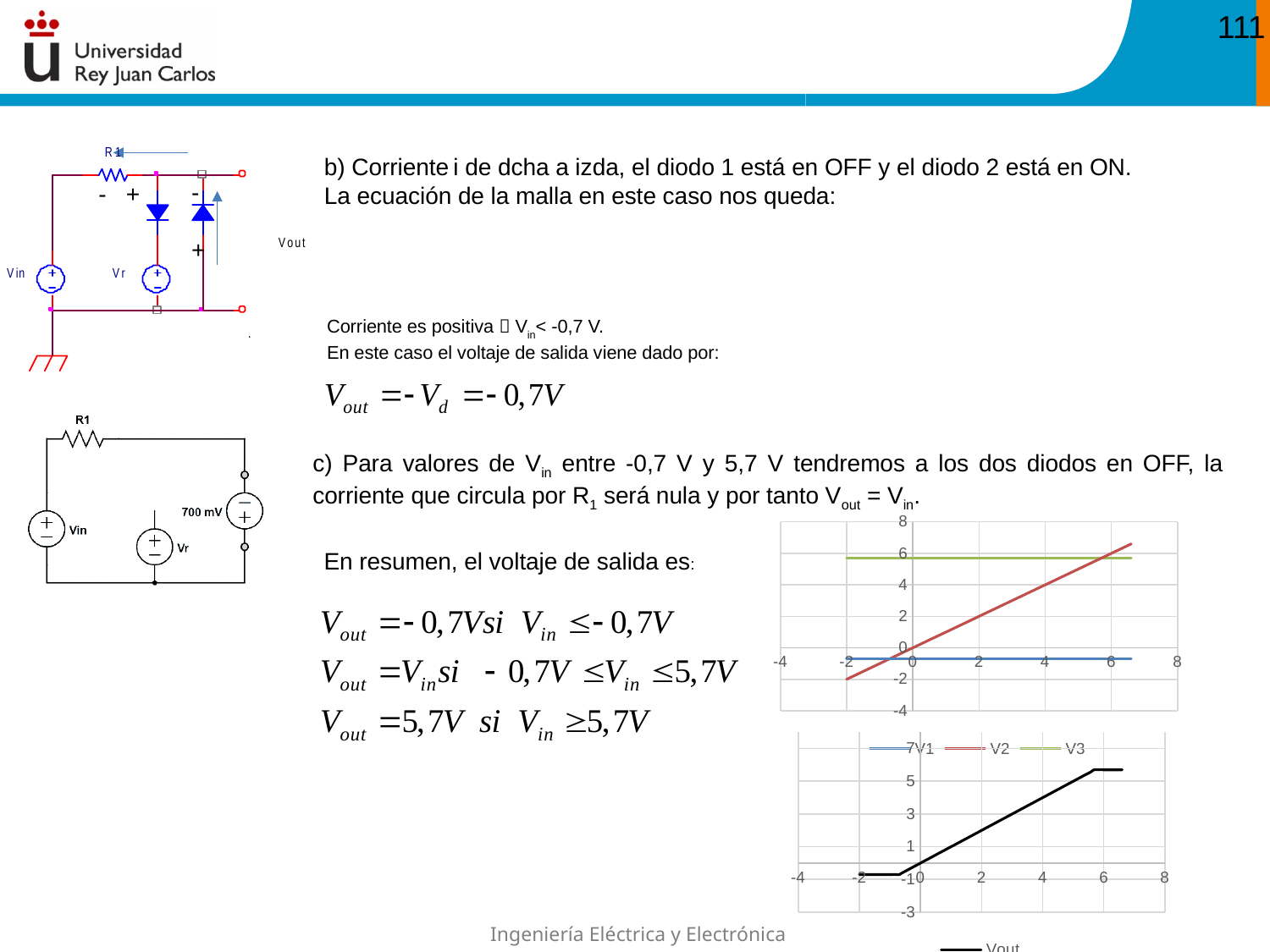
What kind of chart is the lower chart on the right (with series Vout)? line chart In the lower chart, is the value of Vout at x = -2 greater or less than 1? less In the lower chart, is the value of Vout at x = 4 greater or less than 1? greater In the upper chart, is the value of V3 at x = 0 greater or less than 4? greater What are the legend entries of the upper chart? V1, V2, V3 What kind of chart is the upper chart on the right (with series V1, V2 and V3)? line chart How many series does the legend of the lower chart list? 1 In the upper chart, does the V1 series rise or fall as the x axis increases? neither; it stays flat (constant) What is the legend entry of the lower chart? Vout How many series does the legend of the upper chart list? 3